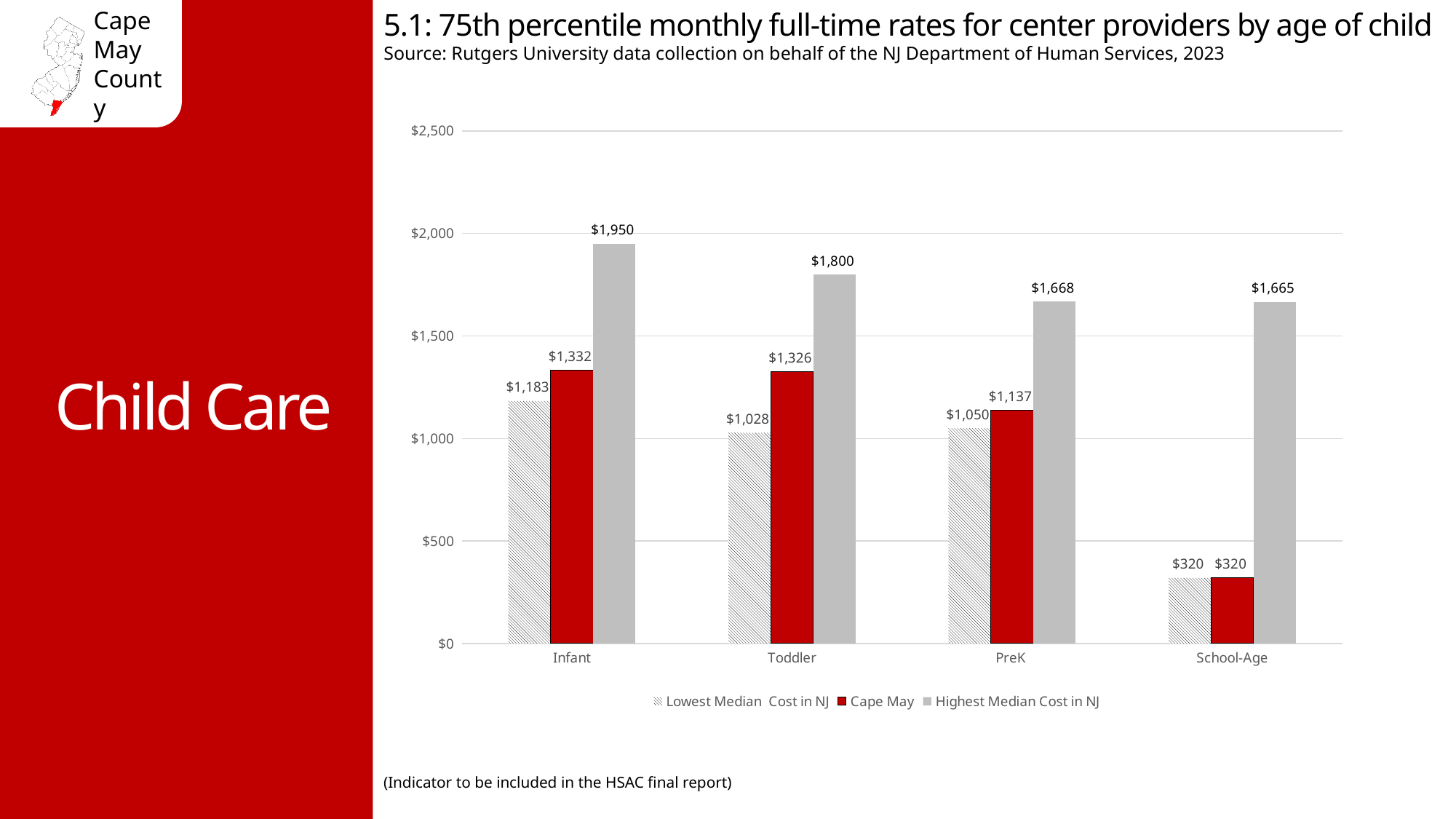
What is the Highest Median Cost in NJ for Toddler? $1,800 What is the Cape May value for Infant? $1,332 Which is larger for Toddler: the Cape May value or the Lowest Median Cost in NJ? Cape May What is the Lowest Median Cost in NJ for PreK? $1,050 How many age groups are shown on the x axis? 4 What is the difference between the Highest Median Cost in NJ and the Cape May value for Infant? $618 Does the Cape May value rise or fall from Infant to School-Age? Fall Which age group has the lowest Cape May value? School-Age What kind of chart is shown? Bar chart How many series does the legend list? 3 Which age group has the highest Highest Median Cost in NJ? Infant What is the Cape May value for School-Age? $320